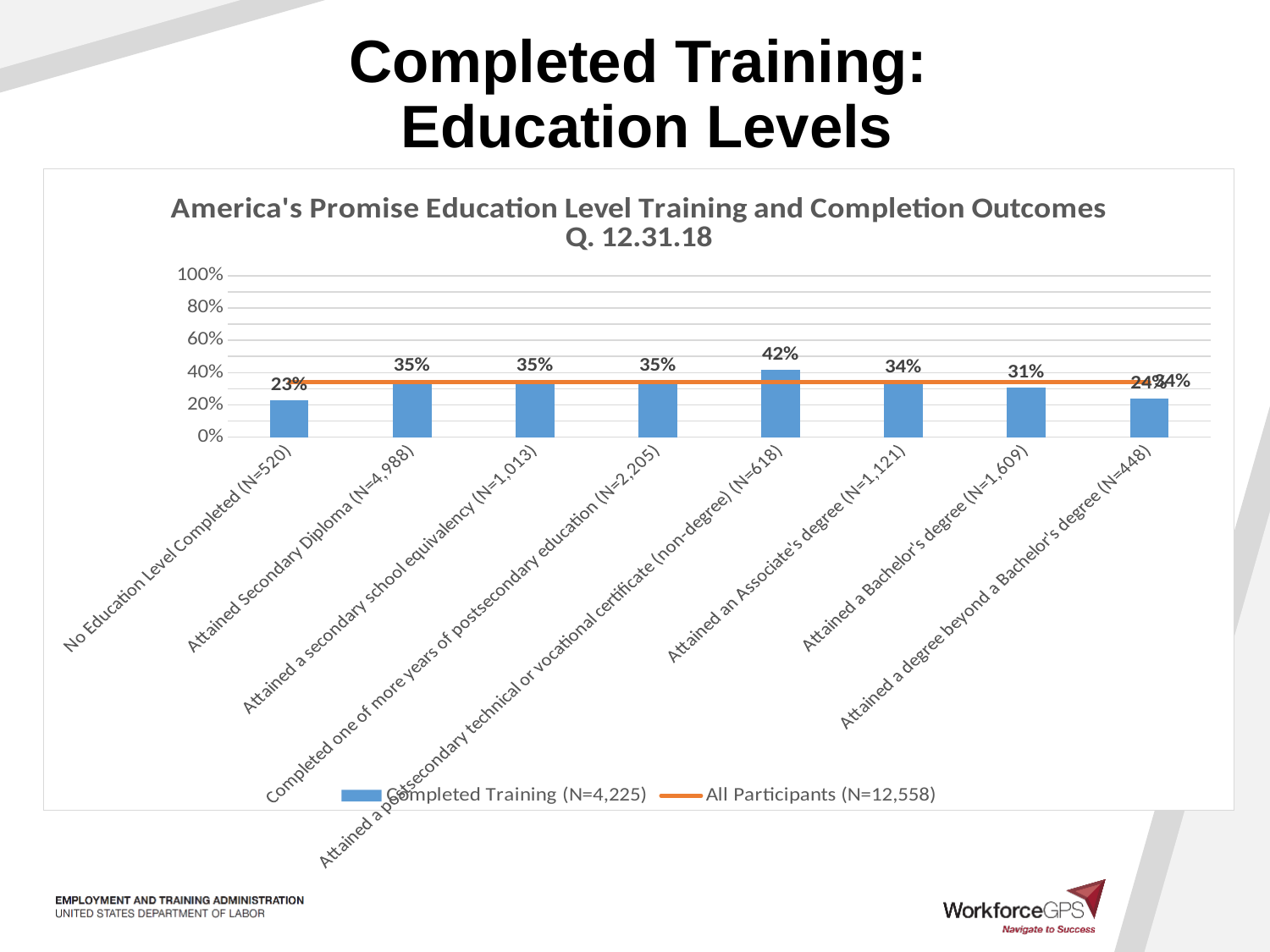
What is the Completed Training value for Attained a postsecondary technical or vocational certificate (non-degree) (N=618)? 42% What is the Completed Training value for No Education Level Completed (N=520)? 23% Which category has the highest Completed Training value? Attained a postsecondary technical or vocational certificate (non-degree) (N=618) What is the title of the chart? America's Promise Education Level Training and Completion Outcomes Q. 12.31.18 What is the Completed Training value for Attained Secondary Diploma (N=4,988)? 35% Which has a larger Completed Training value: Attained an Associate's degree or Attained a Bachelor's degree? Attained an Associate's degree What is the difference between the Completed Training values for Attained a postsecondary technical or vocational certificate (non-degree) and No Education Level Completed? 19 percentage points What is the Completed Training value for Attained a Bachelor's degree (N=1,609)? 31% Is the Completed Training value for Attained a degree beyond a Bachelor's degree (N=448) greater or less than 40%? less How many education level categories are shown on the x axis? 8 What type of chart is shown on the slide? combination bar and line chart How many series does the legend list? 2